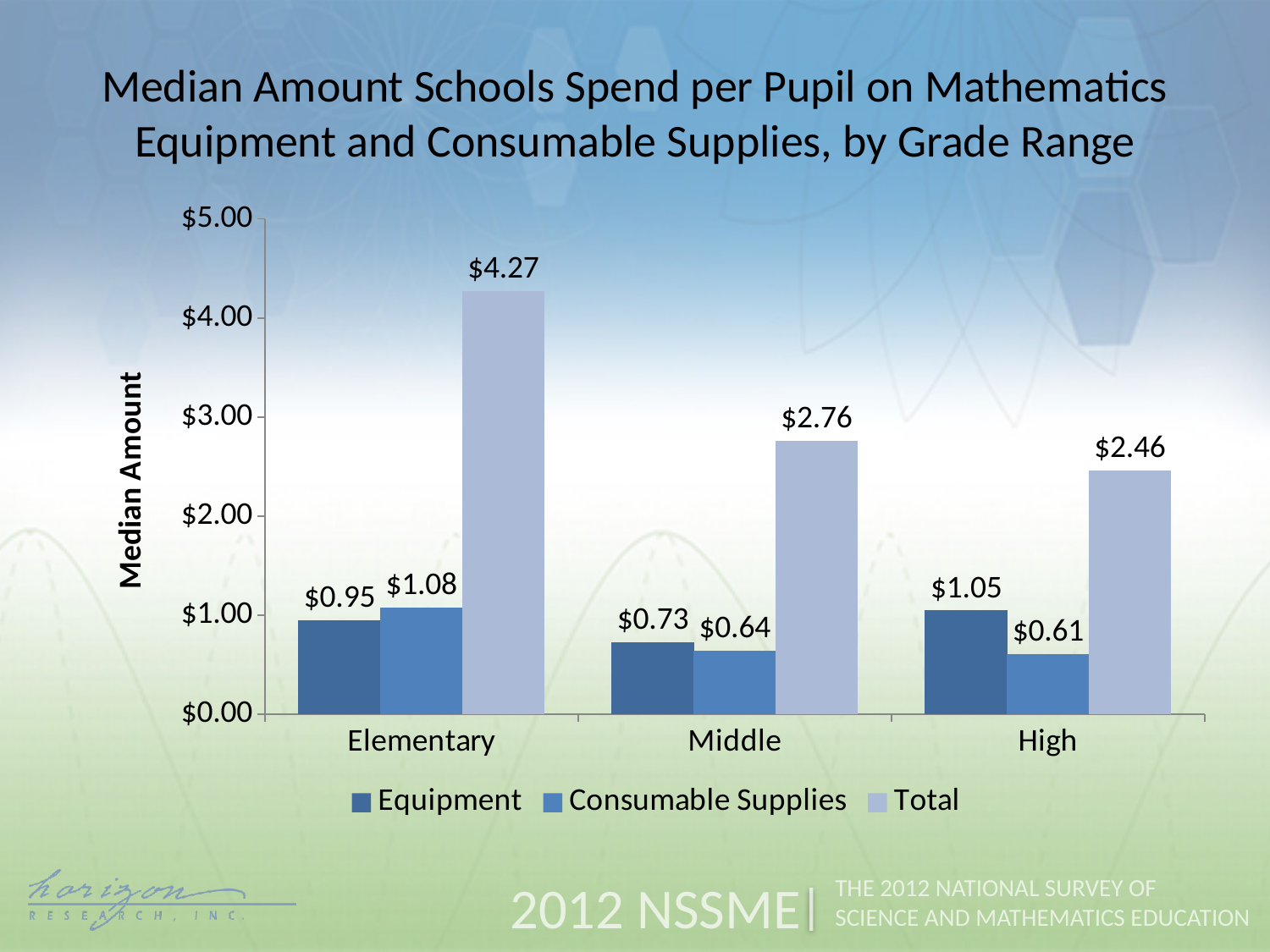
What is the median Equipment amount spent per pupil for High schools? $1.05 Which grade range has the lowest Consumable Supplies median amount? High Which grade range has the highest Total median amount? Elementary How many grade ranges are shown on the x axis? 3 What is the label of the vertical axis? Median Amount What is the difference between the Total median amounts for Elementary and High schools? $1.81 What is the median Consumable Supplies amount spent per pupil for Middle schools? $0.64 What kind of chart is shown on the slide? bar chart What is the median Total amount spent per pupil for Elementary schools? $4.27 Which is larger for Elementary schools: the Equipment amount or the Consumable Supplies amount? Consumable Supplies How many series does the legend list? 3 Is the Total median amount for Middle schools greater or less than $3.00? less